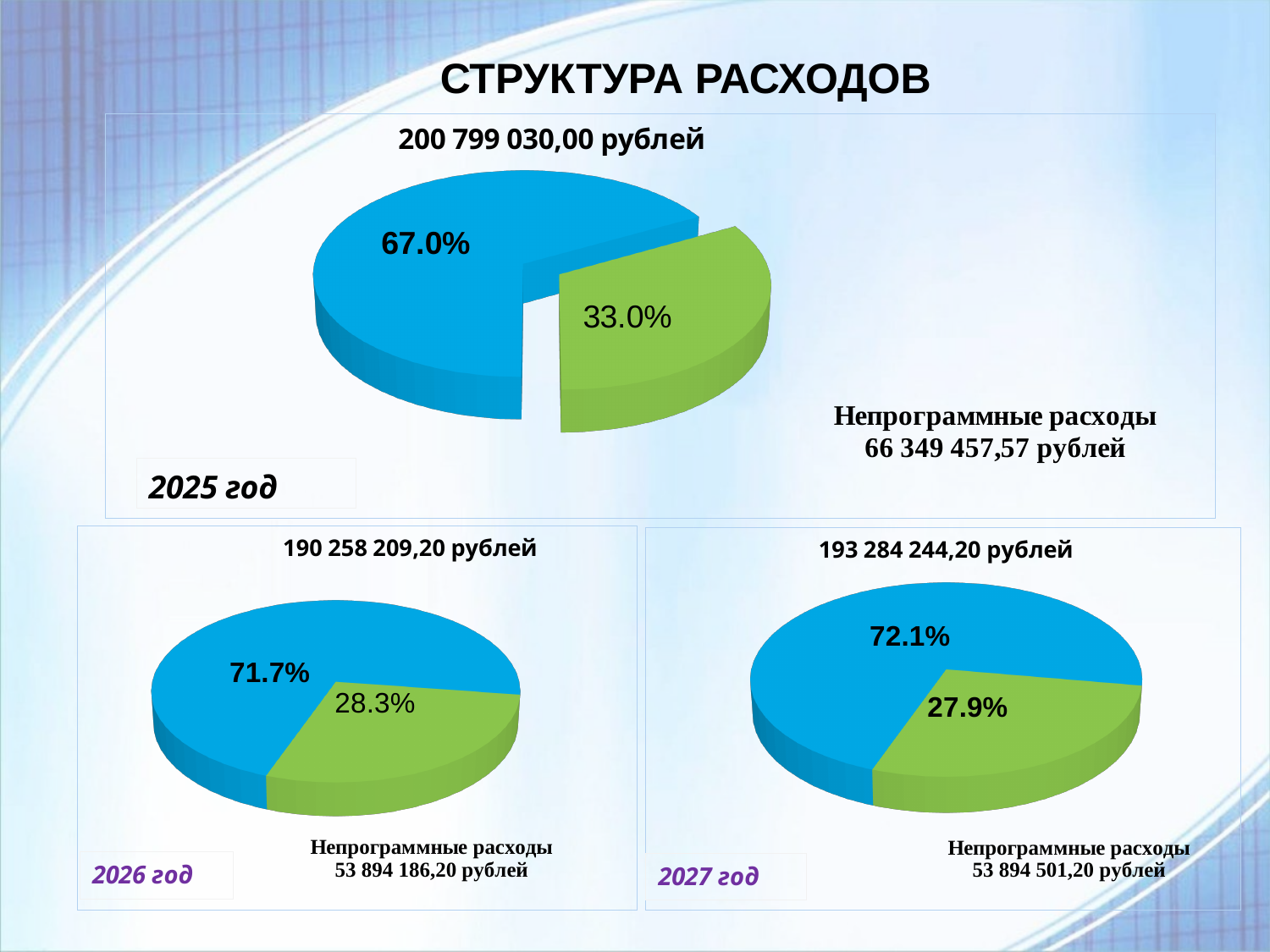
What amount of Непрограммные расходы is shown next to the 2026 год pie chart? 53 894 186,20 рублей In the 2025 год pie chart, what is the difference between the blue slice's share and the green slice's share? 34.0% Which year's pie chart has the smallest green slice share: 2025, 2026 or 2027? 2027 What total amount in rubles is shown as the title of the 2027 год pie chart? 193 284 244,20 рублей In the 2026 год pie chart, which slice is larger, the blue one or the green one? the blue one In the 2025 год pie chart, what share does the green slice have? 33.0% What kind of chart is used for the 2025 год expenditure structure? pie chart How many slices does the 2026 год pie chart have? 2 In the 2027 год pie chart, what share does the green slice have? 27.9% In the 2026 год pie chart, what share does the green slice have? 28.3%